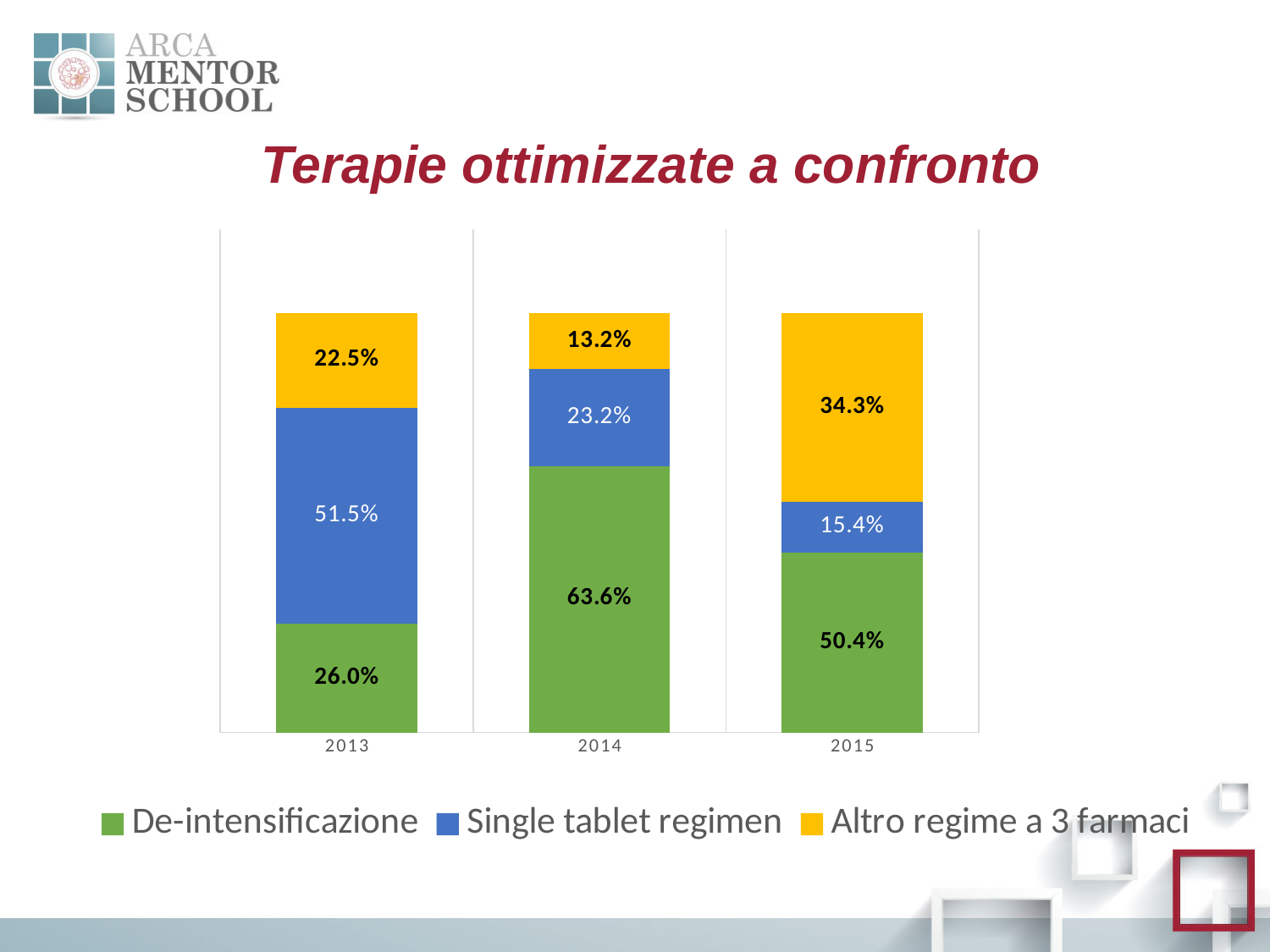
In which year is the De-intensificazione value highest? 2014 How many years are shown on the x axis? 3 What is the value for Altro regime a 3 farmaci in 2015? 34.3% What is the difference between the Single tablet regimen values for 2013 and 2015? 36.1% What is the value for Single tablet regimen in 2014? 23.2% Does the Single tablet regimen value rise or fall from 2013 to 2015? Fall What kind of chart is shown on the slide? Stacked bar chart What is the value for De-intensificazione in 2013? 26.0% In which year is the Altro regime a 3 farmaci value lowest? 2014 Which is larger: De-intensificazione in 2015 or Single tablet regimen in 2013? Single tablet regimen in 2013 What is the value for Single tablet regimen in 2015? 15.4% How many series does the legend list? 3